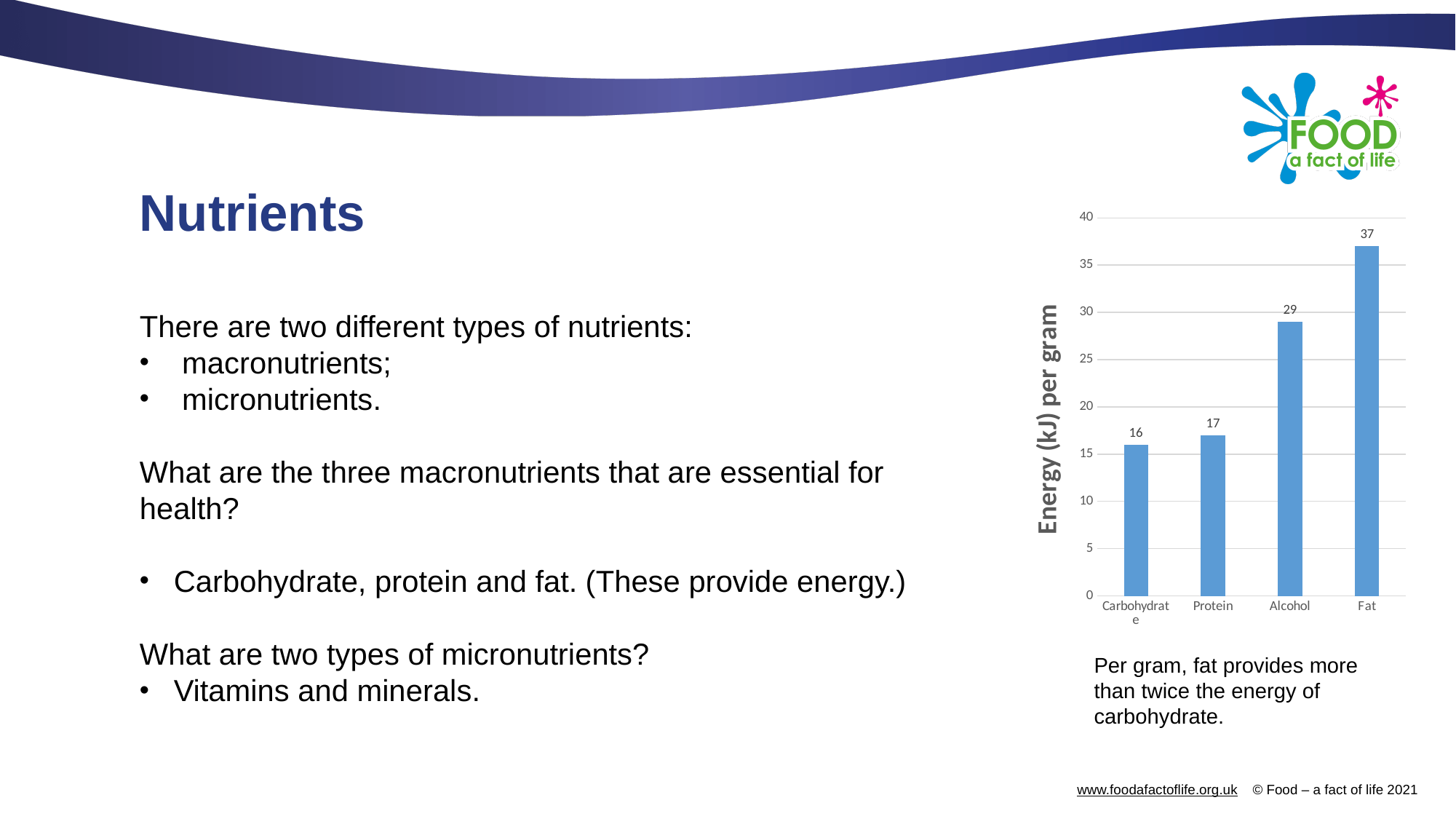
What is the difference in energy per gram between Alcohol and Protein? 12 What is the energy (kJ) per gram for Protein? 17 Is the value for Alcohol greater or less than 25? greater Which category has the lowest energy per gram? Carbohydrate What is the difference in energy per gram between Fat and Carbohydrate? 21 How many categories are shown on the chart? 4 Which provides more energy per gram, Alcohol or Protein? Alcohol What is the energy (kJ) per gram for Fat? 37 Which category has the highest energy per gram? Fat What is the energy (kJ) per gram for Alcohol? 29 What is the energy (kJ) per gram for Carbohydrate? 16 What kind of chart is shown on the slide? Bar chart